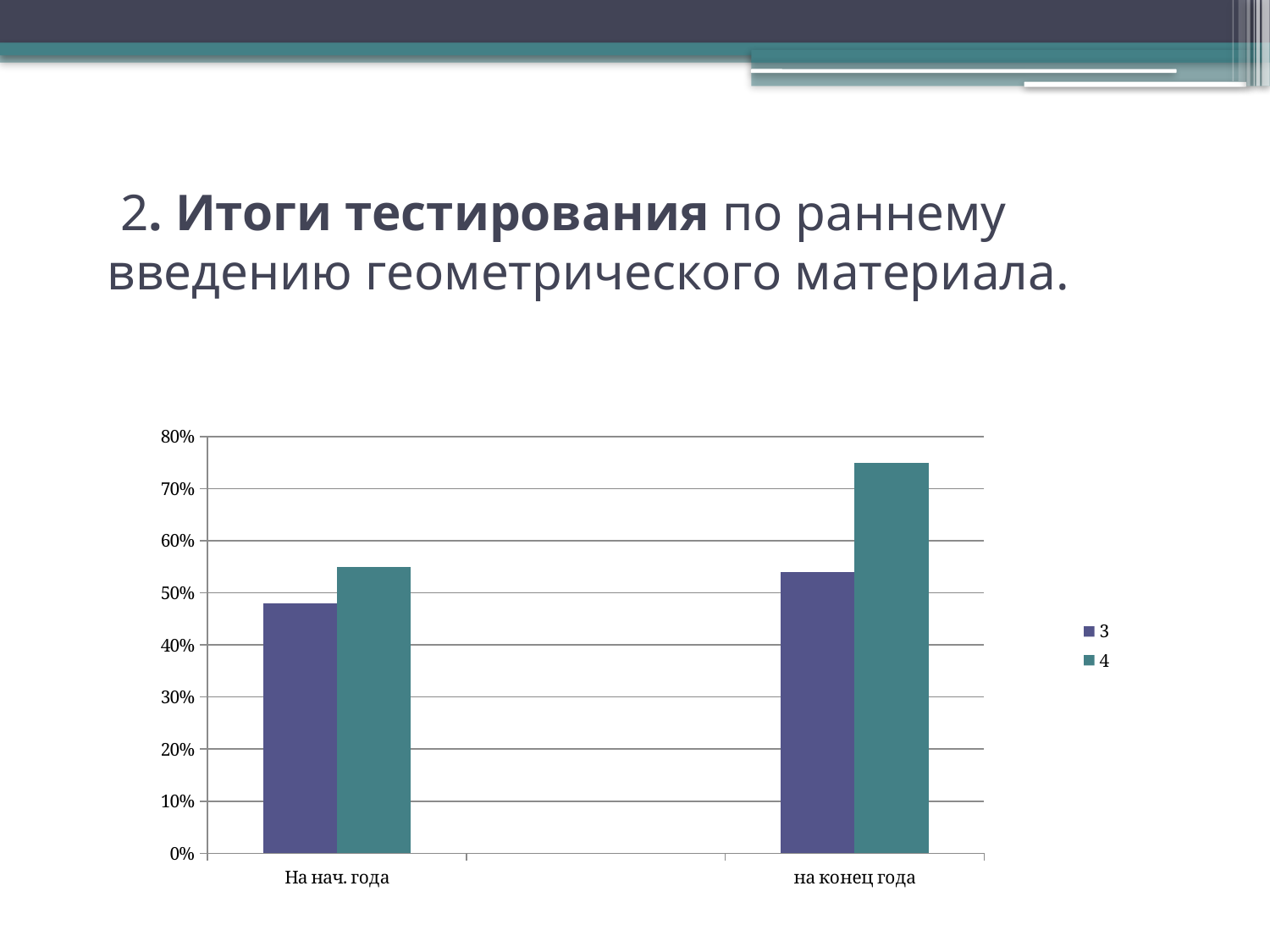
What kind of chart is shown on the slide? bar chart What are the two series names listed in the legend? 3 and 4 How many series does the chart's legend list? 2 Is the value for series 4 at 'На нач. года' greater or less than 60%? less Is the value for series 4 at 'на конец года' greater or less than 70%? greater What are the two category labels on the x axis? На нач. года and на конец года At 'на конец года', which series has the larger value, 3 or 4? 4 Is the value for series 3 at 'на конец года' greater or less than 60%? less How many categories are shown on the x axis of the chart? 2 Which bar in the chart is the highest? series 4 at на конец года Does the value for series 4 rise or fall from 'На нач. года' to 'на конец года'? rise